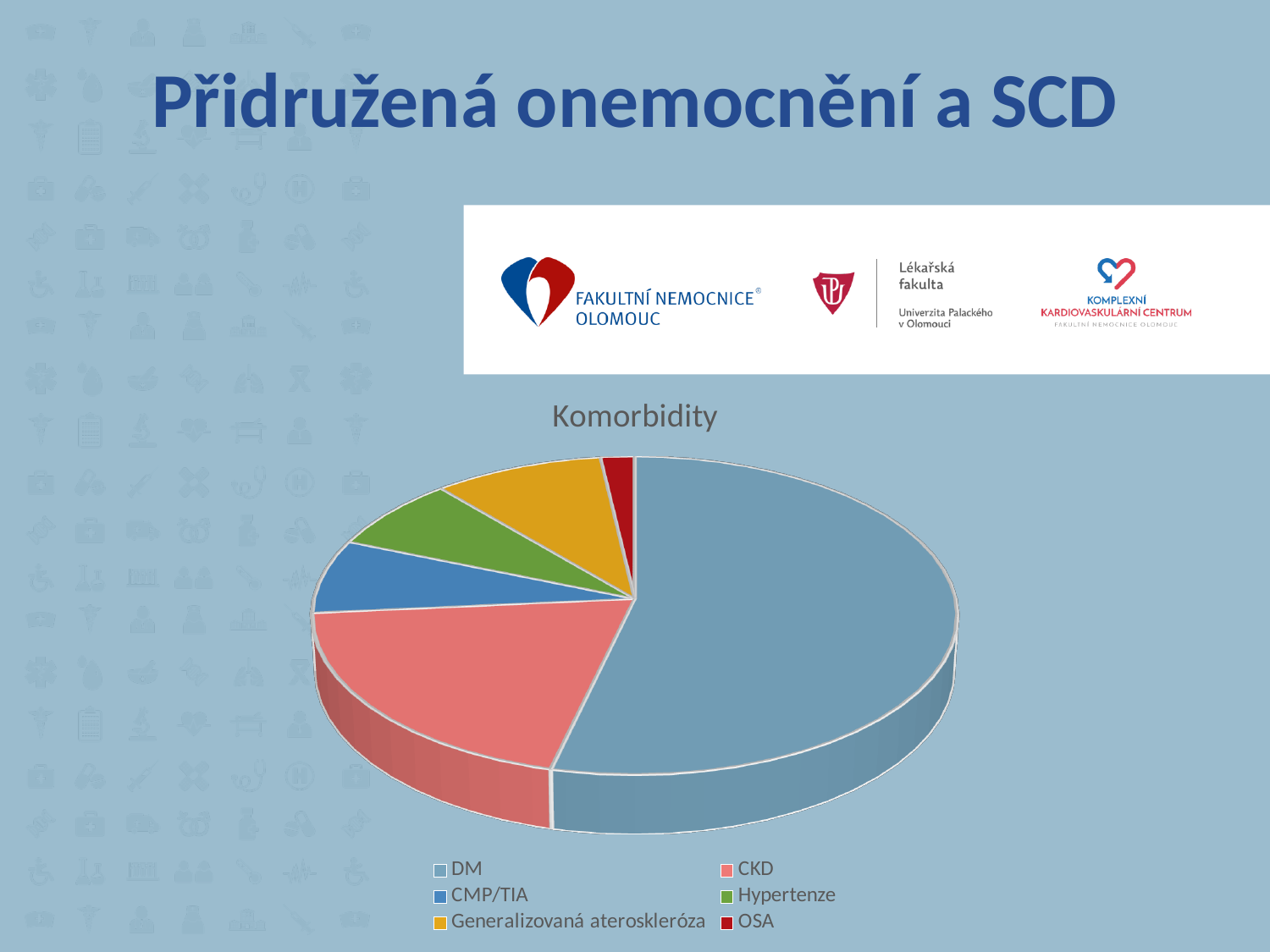
Which slice is larger, Generalizovaná ateroskleróza or OSA? Generalizovaná ateroskleróza Which slice is larger, CKD or CMP/TIA? CKD Which category has the smallest slice of the pie? OSA What is the title of the chart? Komorbidity How many entries does the legend list? 6 How many categories does the pie chart have? 6 Which category has the second largest slice of the pie? CKD What kind of chart is shown on the slide? pie chart Which slice is larger, CKD or Hypertenze? CKD Which category is shown in red in the pie chart? OSA Which category has the largest slice of the pie? DM